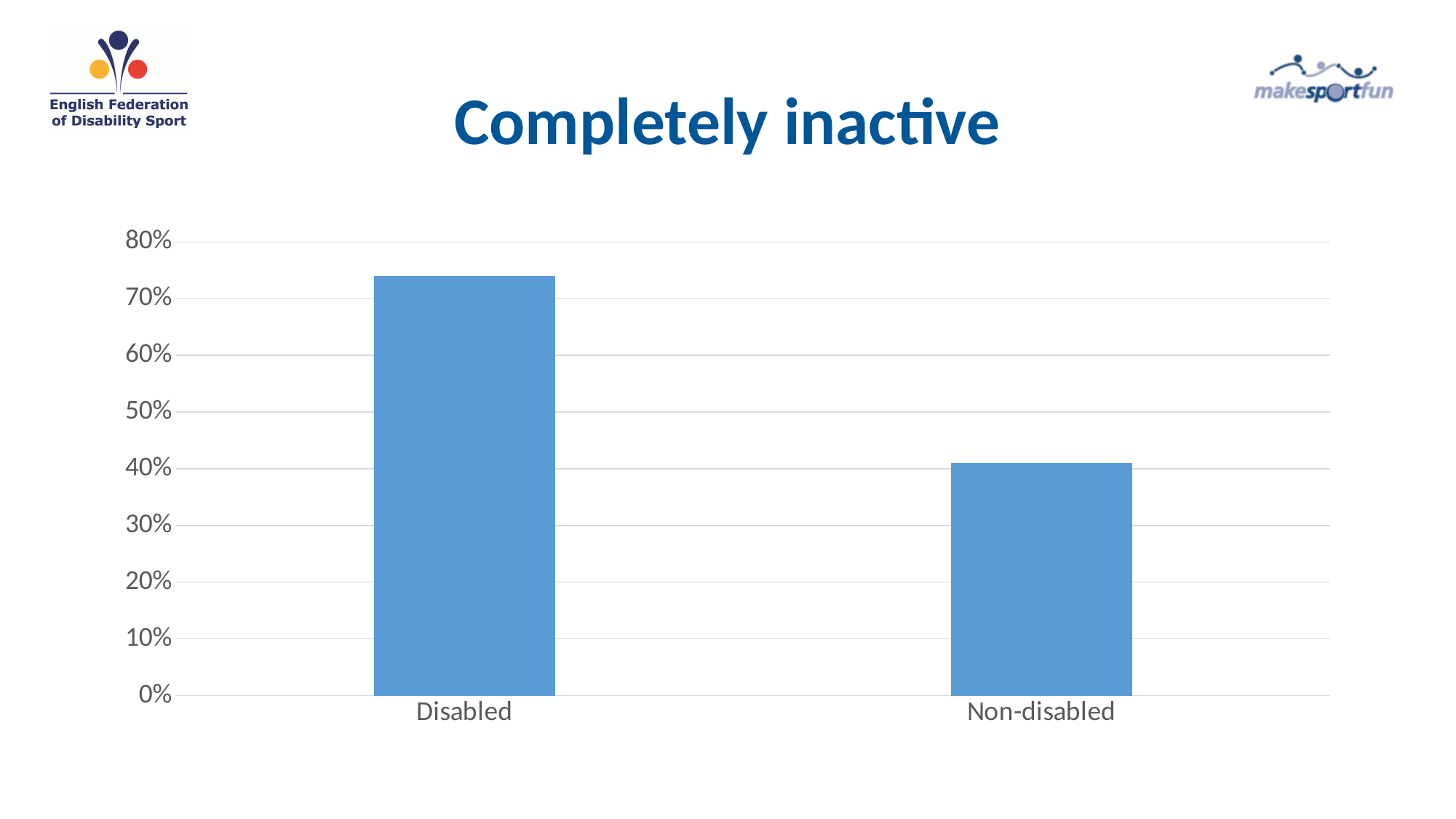
Is the value for Disabled greater or less than 70%? greater Which is larger, the value for Disabled or the value for Non-disabled? Disabled How many categories are plotted on the chart? 2 Which category has the highest value? Disabled What is the title of the slide containing the chart? Completely inactive Is the value for Disabled greater or less than 80%? less What is the highest value shown on the vertical axis? 80% Is the value for Non-disabled greater or less than 50%? less What kind of chart is shown on the slide? bar chart Which category has the lowest value? Non-disabled